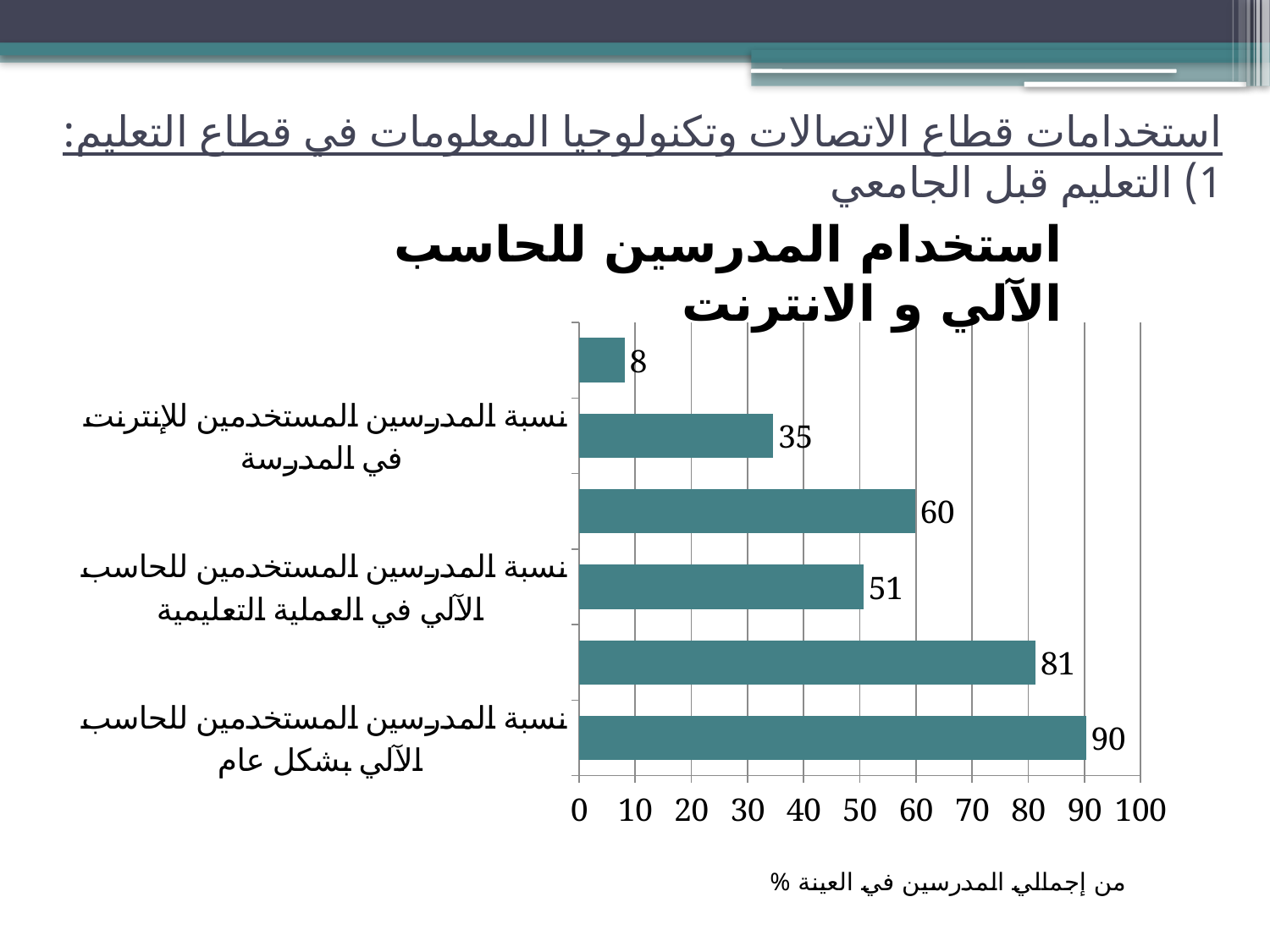
How many category labels are shown on the vertical axis of the chart? 3 What is the maximum value shown on the horizontal axis of the chart? 100 What is the lowest value shown on any bar in the chart? 8 Which is larger: the bar labelled 35 or the bar labelled 51? 51 What is the title of the chart? استخدام المدرسين للحاسب الآلي و الانترنت What is the highest value shown on any bar in the chart? 90 How many bars are plotted in the chart? 6 What kind of chart is shown on the slide? bar chart